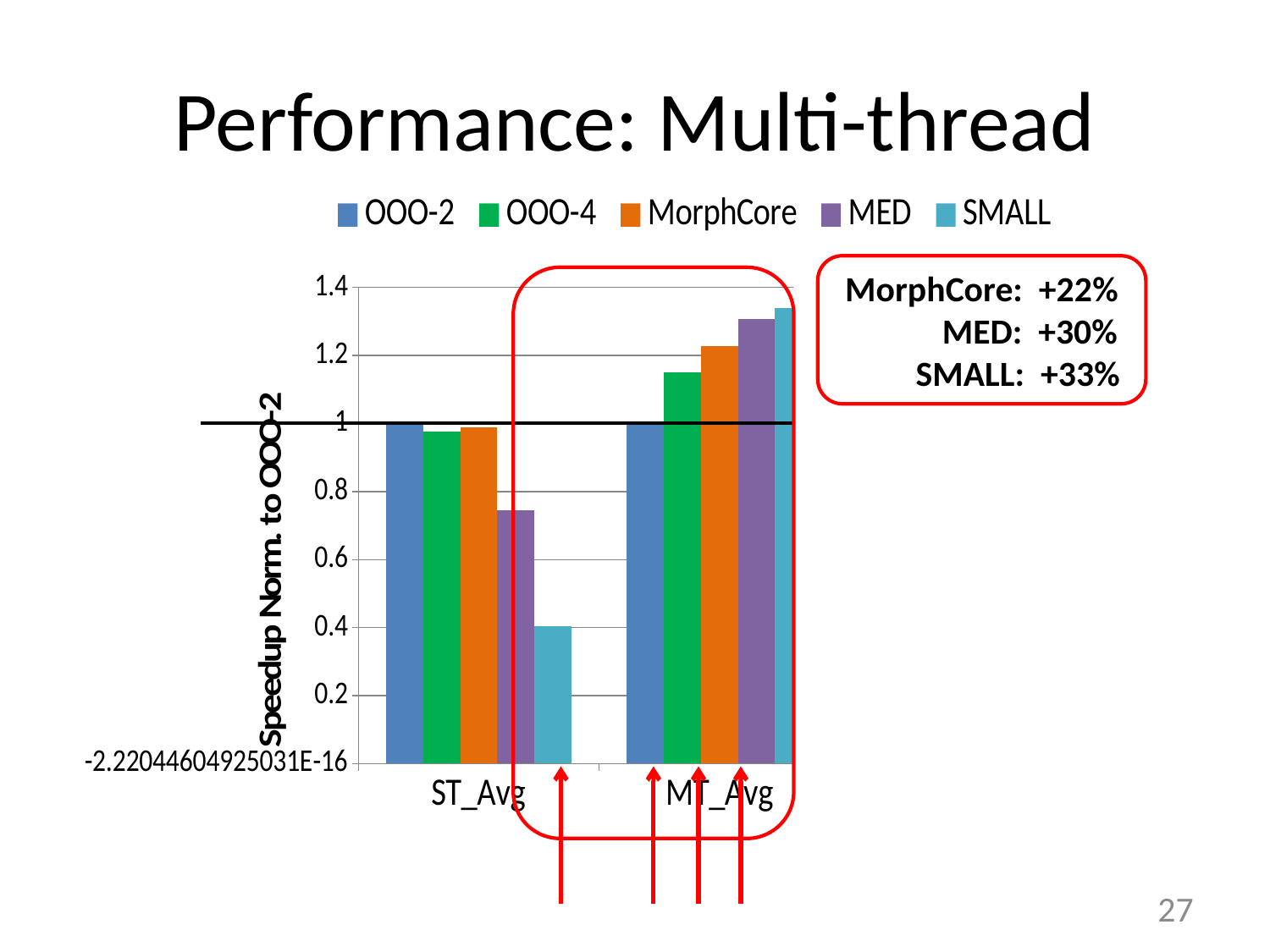
How many series does the legend list? 5 According to the annotation box, what is the improvement shown for MED? +30% What is the title of the y axis? Speedup Norm. to OOO-2 Is the value for OOO-4 in the MT_Avg category greater or less than 1.2? less What is the value for OOO-2 in the MT_Avg category? 1 Is the value for SMALL in the MT_Avg category greater or less than 1.2? greater What kind of chart is shown on the slide? bar chart Which series has the lowest value in the ST_Avg category? SMALL Is the value for MED in the ST_Avg category greater or less than 0.6? greater Which series has the highest value in the MT_Avg category? SMALL How many categories are shown on the x axis? 2